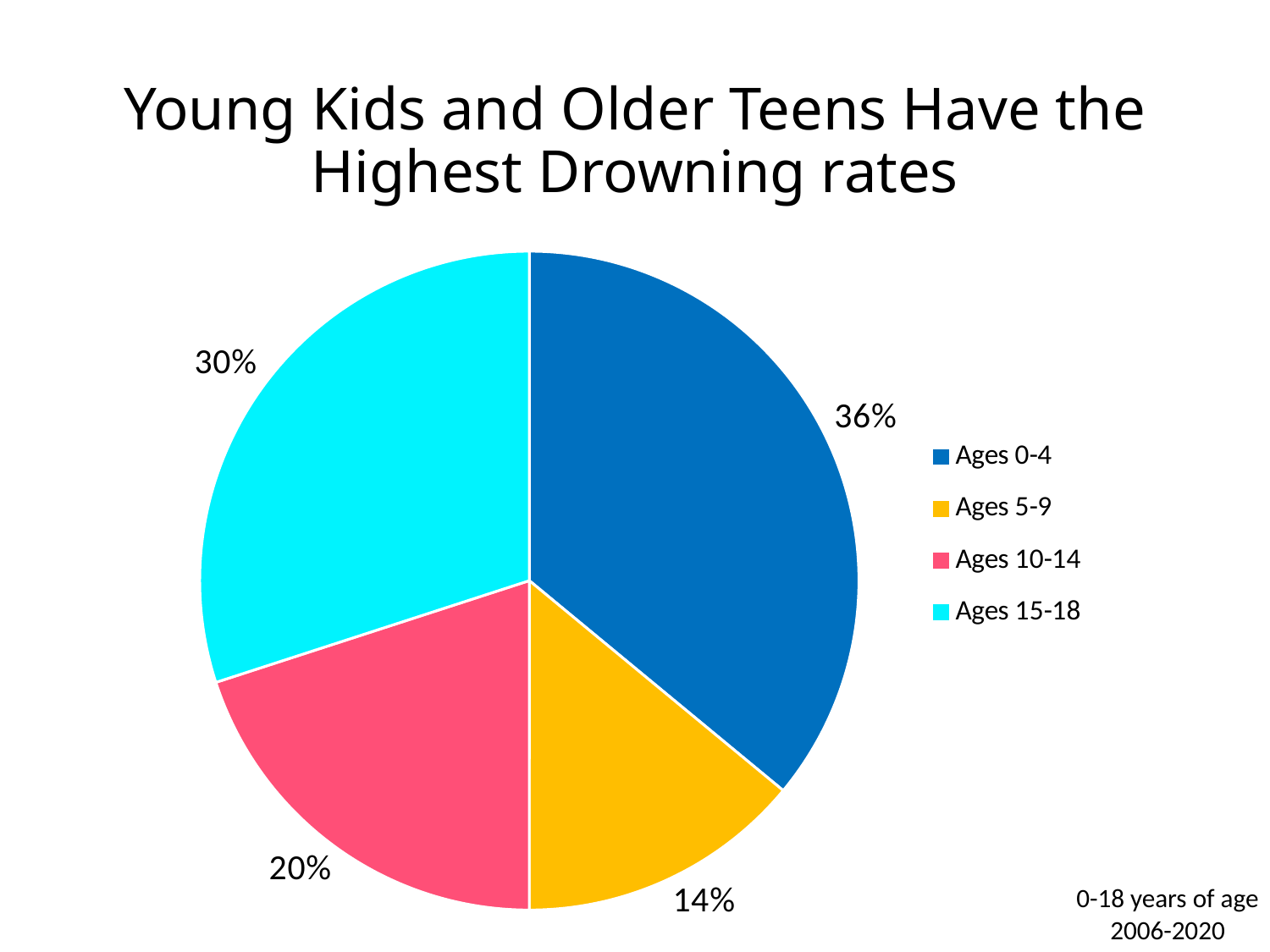
What share of the pie is Ages 5-9? 14% Which is larger, the share for Ages 10-14 or the share for Ages 5-9? Ages 10-14 What kind of chart is shown on the slide? Pie chart Which age group has the smallest slice of the pie? Ages 5-9 What colour is the slice for Ages 5-9? Yellow What share of the pie is Ages 10-14? 20% What share of the pie is Ages 15-18? 30% What is the title of the chart? Young Kids and Older Teens Have the Highest Drowning rates How many age groups does the legend list? 4 Which age group has the largest slice of the pie? Ages 0-4 What is the difference in percentage points between Ages 0-4 and Ages 15-18? 6 What share of the pie is Ages 0-4? 36%